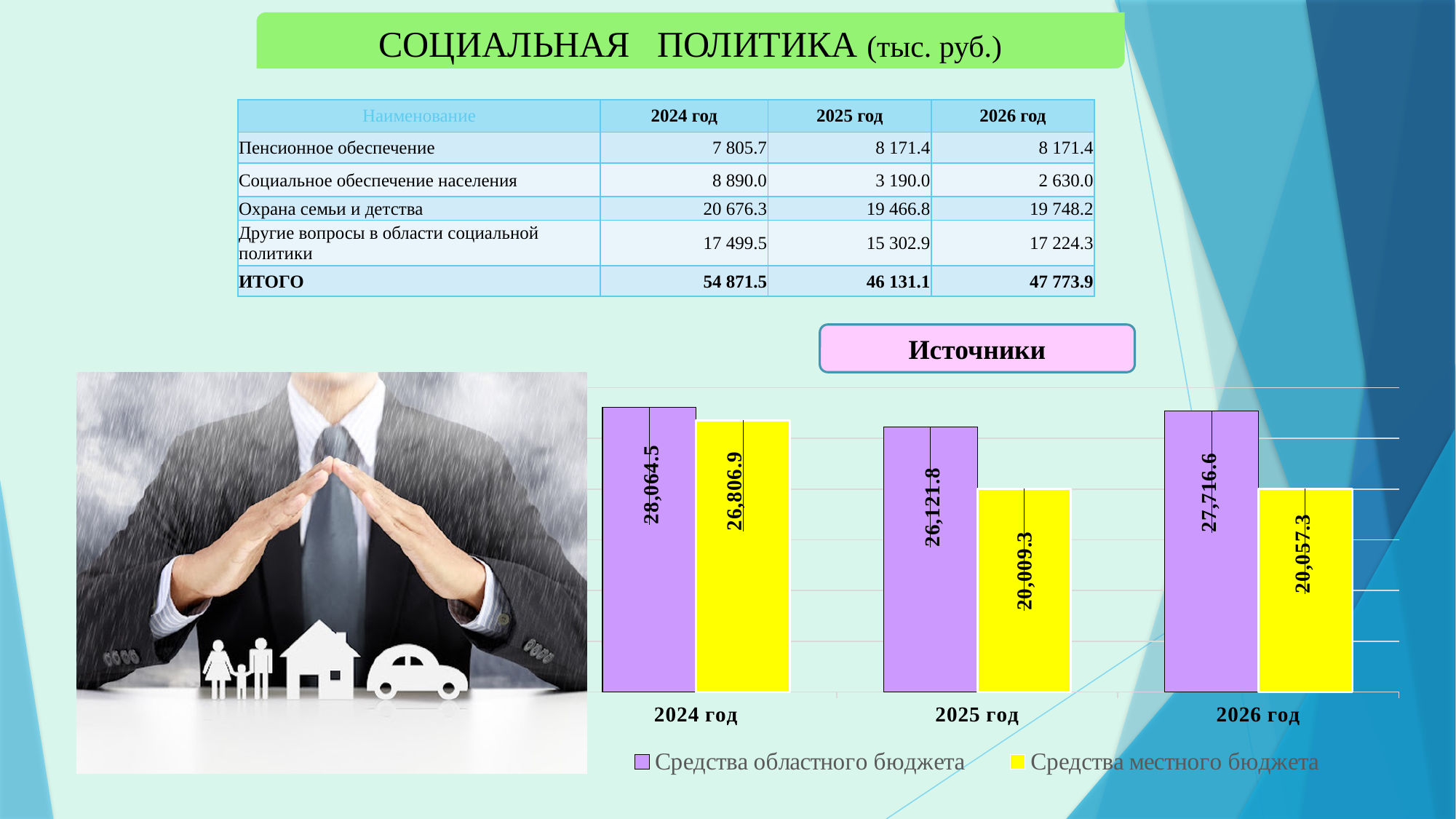
How many series does the legend of the "Источники" chart list? 2 In the "Источники" chart, which year has the highest value for Средства областного бюджета? 2024 год In the "Источники" chart, what is the value of Средства местного бюджета for 2025 год? 20,009.3 In the "Источники" chart, which year has the lowest value for Средства местного бюджета? 2025 год How many years are shown on the x axis of the "Источники" chart? 3 In the "Источники" chart, what is the value of Средства областного бюджета for 2026 год? 27,716.6 In the "Источники" chart, what is the difference between Средства областного бюджета and Средства местного бюджета for 2025 год? 6,112.5 In the "Источники" chart, what is the value of Средства областного бюджета for 2024 год? 28,064.5 What type of chart is shown under the heading "Источники"? bar chart In the "Источники" chart, what is the difference between Средства областного бюджета and Средства местного бюджета for 2024 год? 1,257.6 In the "Источники" chart, what is the value of Средства местного бюджета for 2026 год? 20,057.3 In the "Источники" chart, which is larger for 2026 год: Средства областного бюджета or Средства местного бюджета? Средства областного бюджета